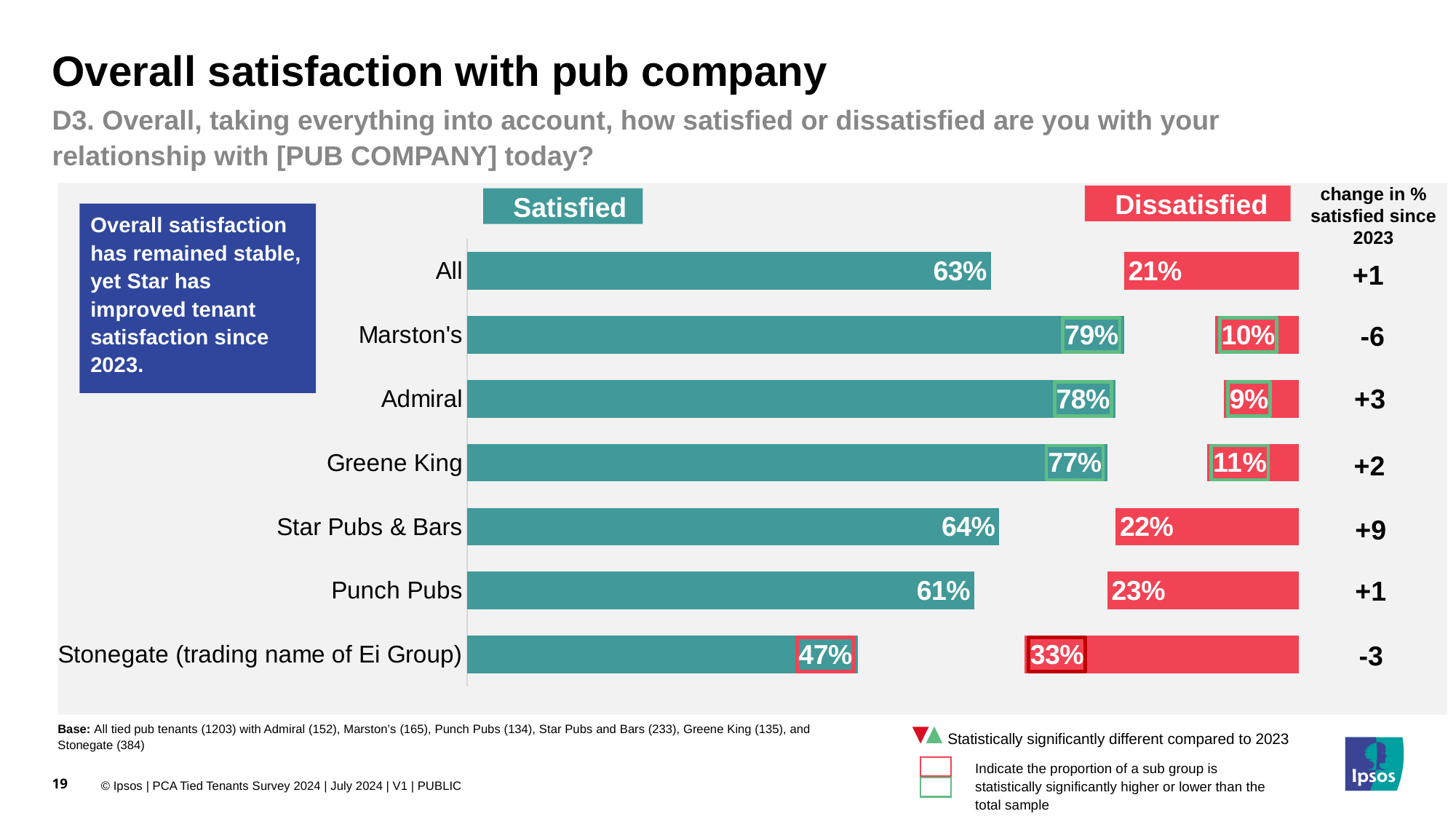
What colour are the Dissatisfied bars? Red What percentage of Marston's tenants are satisfied? 79% What is the dissatisfied percentage for Stonegate (trading name of Ei Group)? 33% Which pub company has the highest satisfied percentage? Marston's What is the difference between the satisfied percentages for Marston's and Stonegate (trading name of Ei Group)? 32 percentage points Which pub company has the lowest satisfied percentage? Stonegate (trading name of Ei Group) What kind of chart is shown on the slide? Bar chart What is the change in % satisfied since 2023 for Star Pubs & Bars? +9 Which pub company has the lowest dissatisfied percentage? Admiral Which is larger, the dissatisfied percentage for Punch Pubs or for Star Pubs & Bars? Punch Pubs How many categories (rows) are shown in the chart? 7 How many series does the chart show? 2